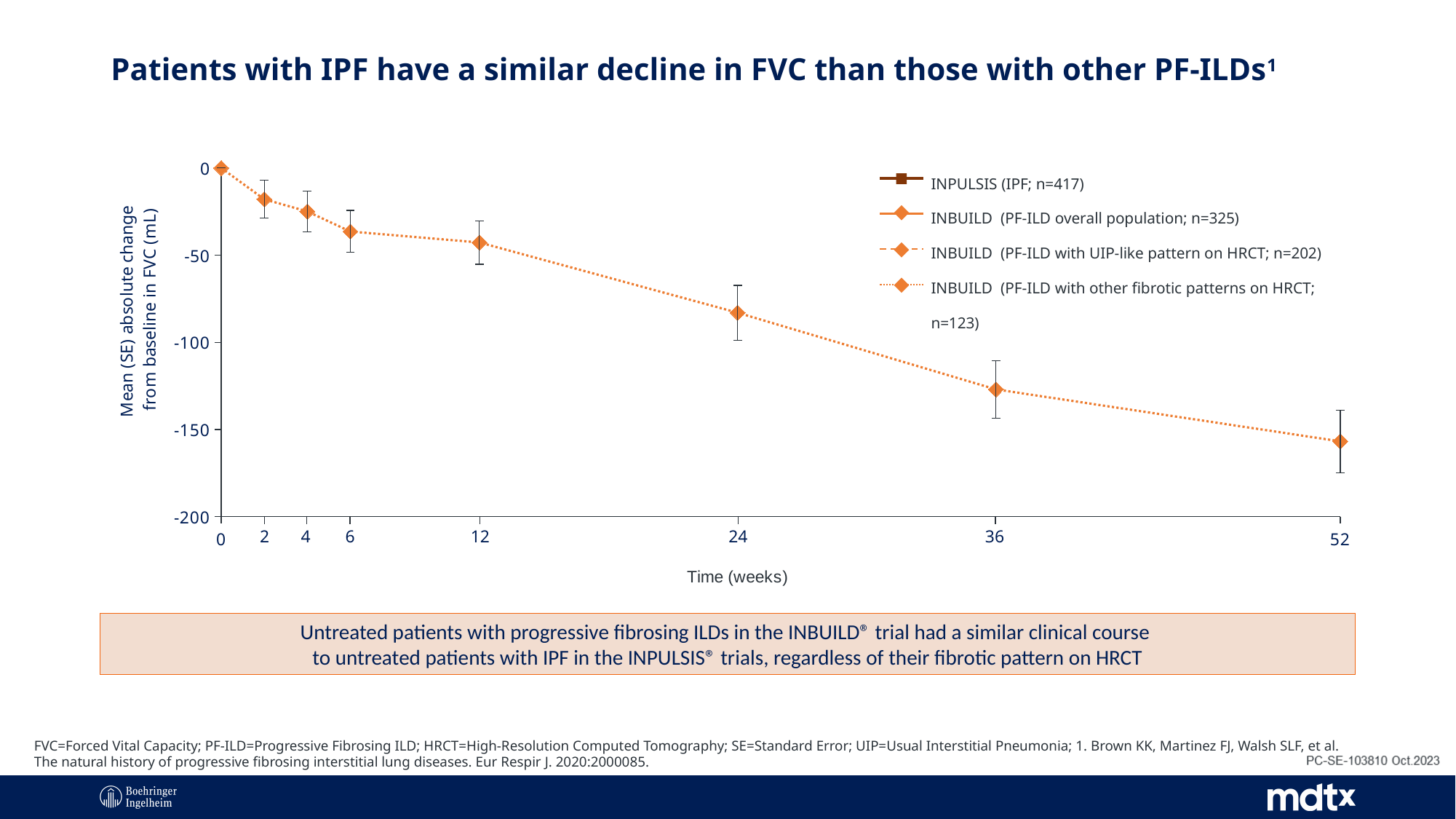
How many series does the legend list? 4 At which time point is the mean change from baseline in FVC lowest? 52 weeks At which time point is the mean change from baseline in FVC highest? 0 weeks What is the mean absolute change from baseline in FVC at week 0? 0 Is the value at 36 weeks greater or less than -100? less Is the value at 12 weeks greater or less than -50? greater How many time points are plotted along the x axis? 8 What is the label of the x axis? Time (weeks) Which is larger, the mean change from baseline in FVC at 24 weeks or at 52 weeks? 24 weeks Is the value at 24 weeks greater or less than -100? greater Do the plotted values rise or fall as time in weeks increases? Fall What kind of chart is shown on the slide? Line chart